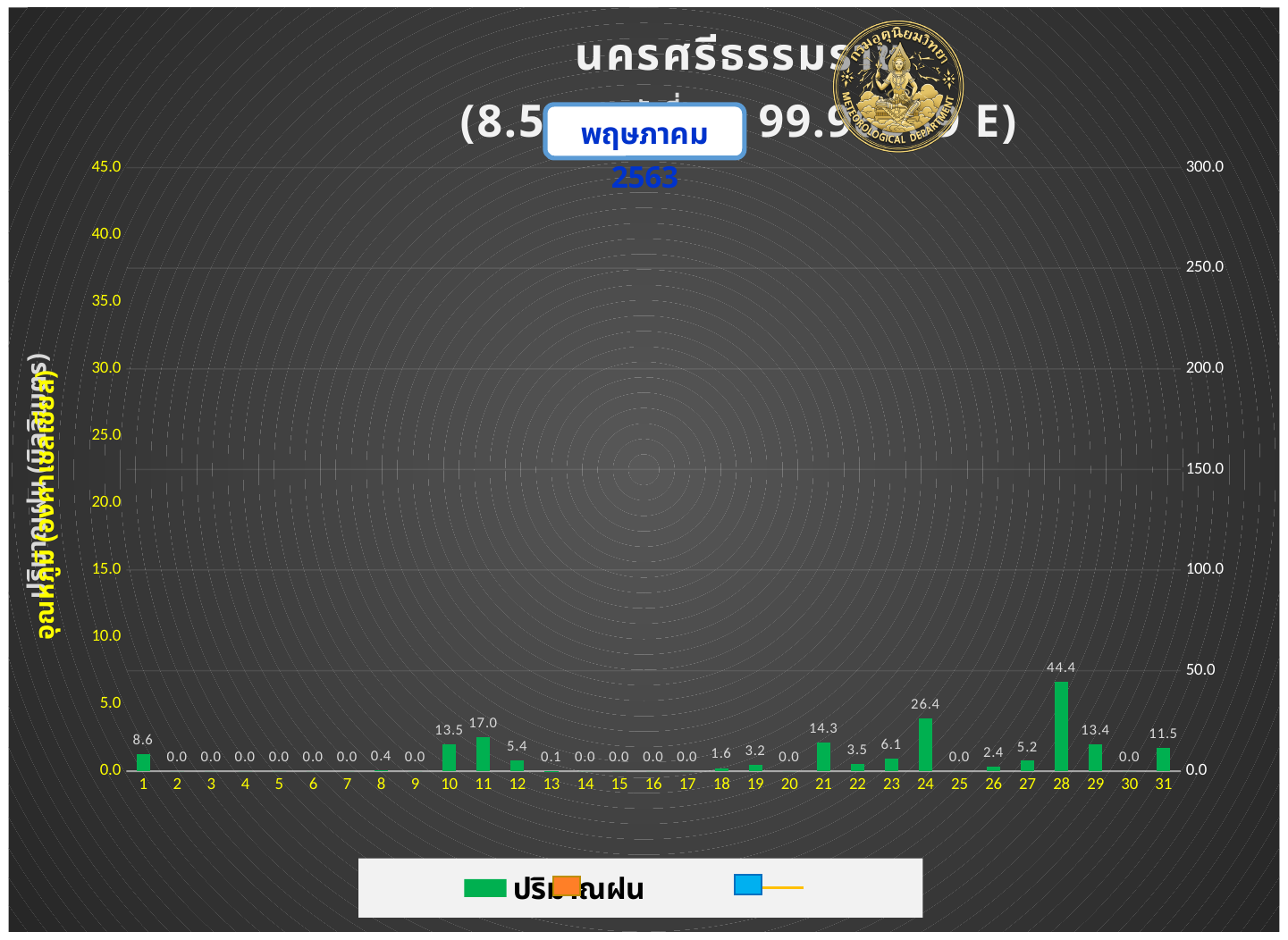
What is the value for day 24? 26.4 What is the difference between the values for day 28 and day 24? 18.0 What is the difference between the values for day 11 and day 10? 3.5 What kind of chart is this? bar chart What is the value for day 1? 8.6 How many days are shown on the x axis? 31 Which is larger, the value for day 12 or the value for day 23? day 23 What is the value for day 11? 17.0 Which day has the highest value? 28 What colour are the bars in the chart? green Which is larger, the value for day 21 or the value for day 29? day 21 What is the value for day 28? 44.4